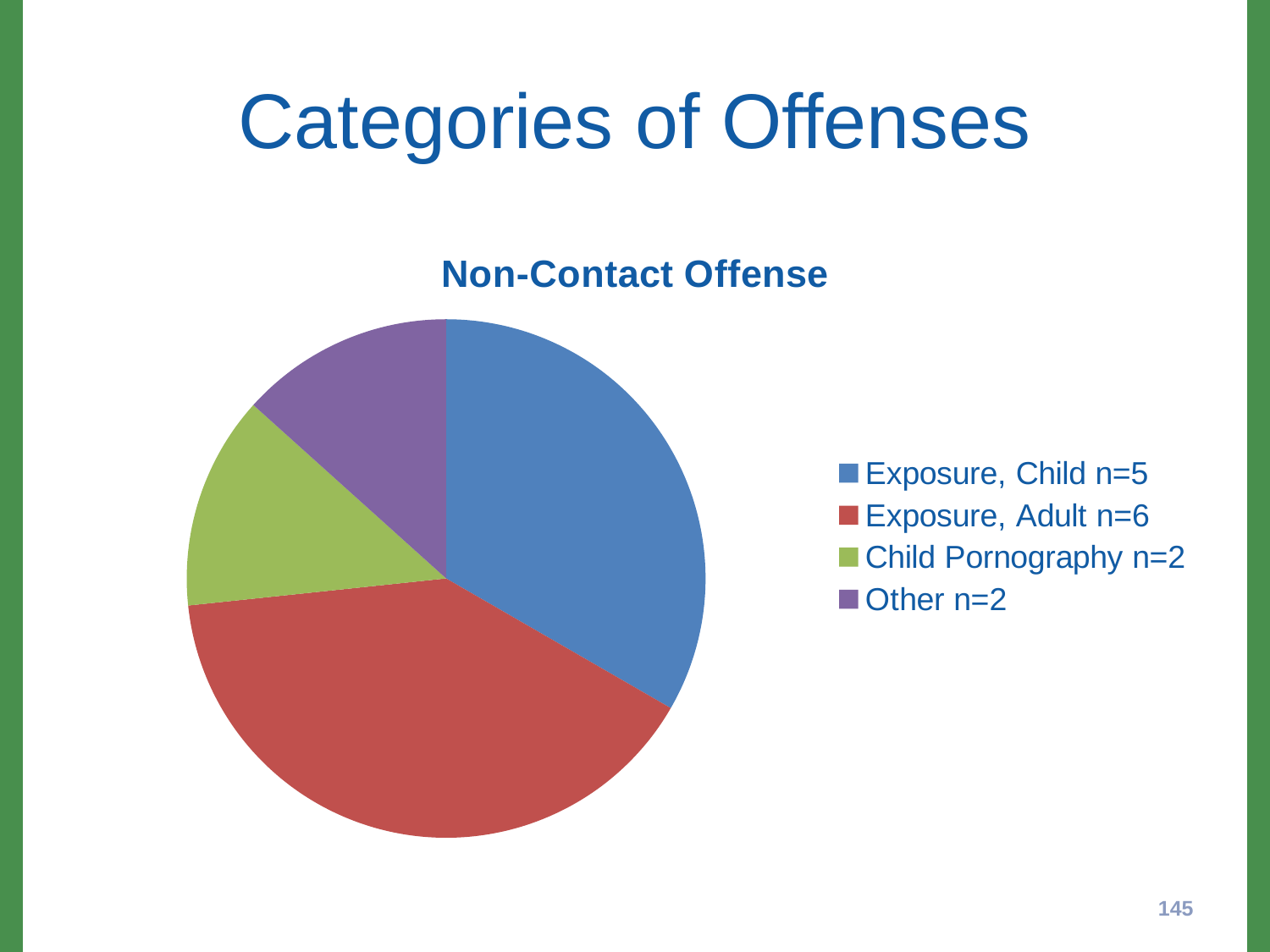
What is the n value for Exposure, Child? n=5 What share of the pie does Exposure, Adult represent? 40% How many categories does the pie chart show? 4 What is the title of the pie chart? Non-Contact Offense Which category has the largest slice of the pie? Exposure, Adult Which colour represents Exposure, Child in the pie chart? blue Which is larger, Exposure, Adult or Exposure, Child? Exposure, Adult What is the n value for Exposure, Adult? n=6 What is the n value for Other? n=2 What type of chart is shown on the slide? pie chart What is the difference between the n values for Exposure, Child and Child Pornography? 3 What is the n value for Child Pornography? n=2